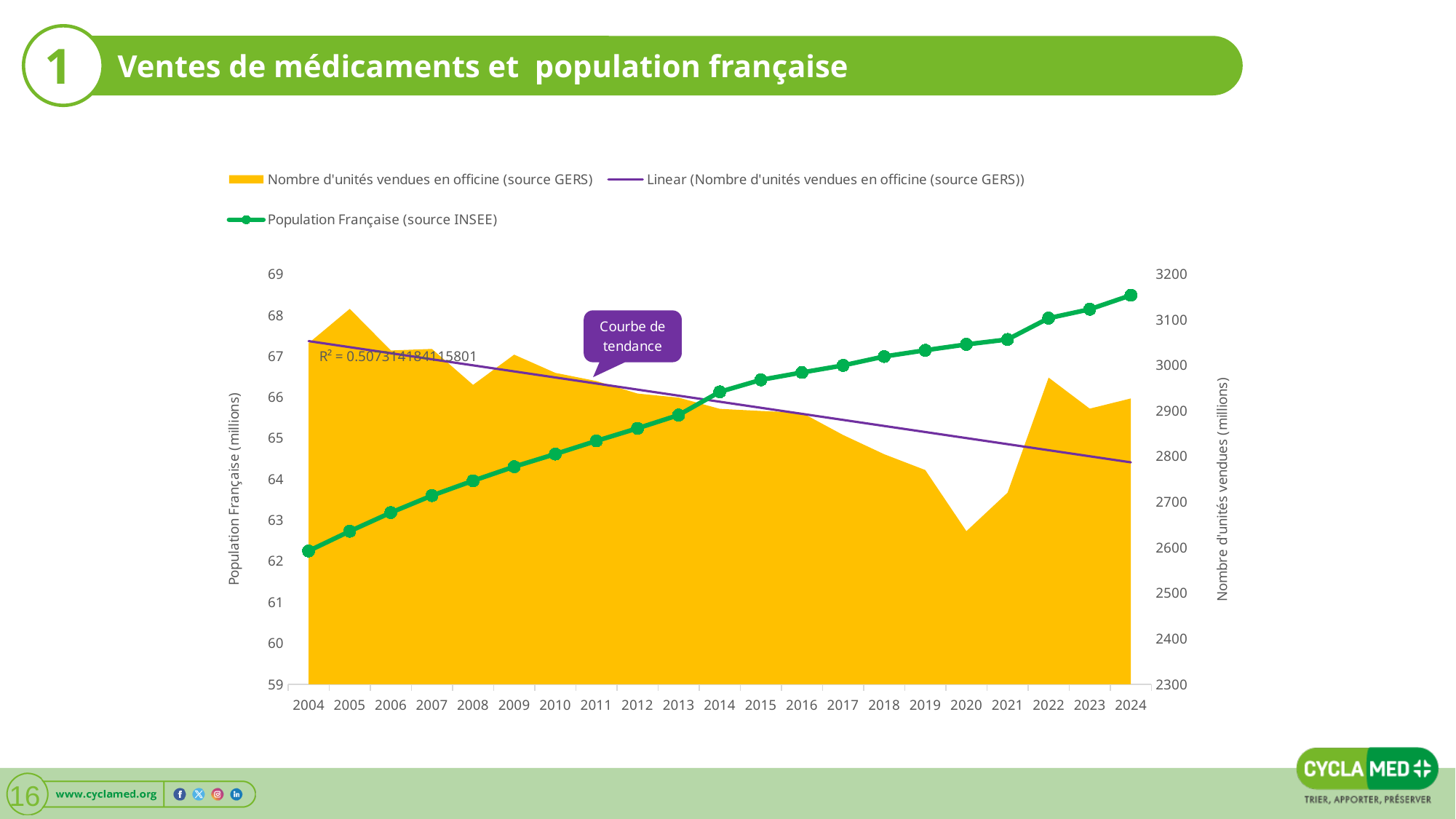
In which year is the 'Nombre d'unités vendues en officine' value lowest? 2020 Does the 'Population Française (source INSEE)' series rise or fall from 2004 to 2024? rise What R² value is printed on the chart for the trend line? R² = 0.507314184115801 In which year is the 'Nombre d'unités vendues en officine' value highest? 2005 How many series does the chart legend list? 3 Is the 'Population Française' value for 2004 greater or less than 63? less How many years are shown on the x axis of the chart? 21 Which year has the larger 'Nombre d'unités vendues en officine' value, 2005 or 2020? 2005 Is the 'Nombre d'unités vendues en officine' value for 2020 greater or less than 2700? less What kind of chart is used for the 'Population Française (source INSEE)' series? line chart Does the linear trend line for 'Nombre d'unités vendues en officine' rise or fall from 2004 to 2024? fall In which year is the 'Population Française' value lowest? 2004